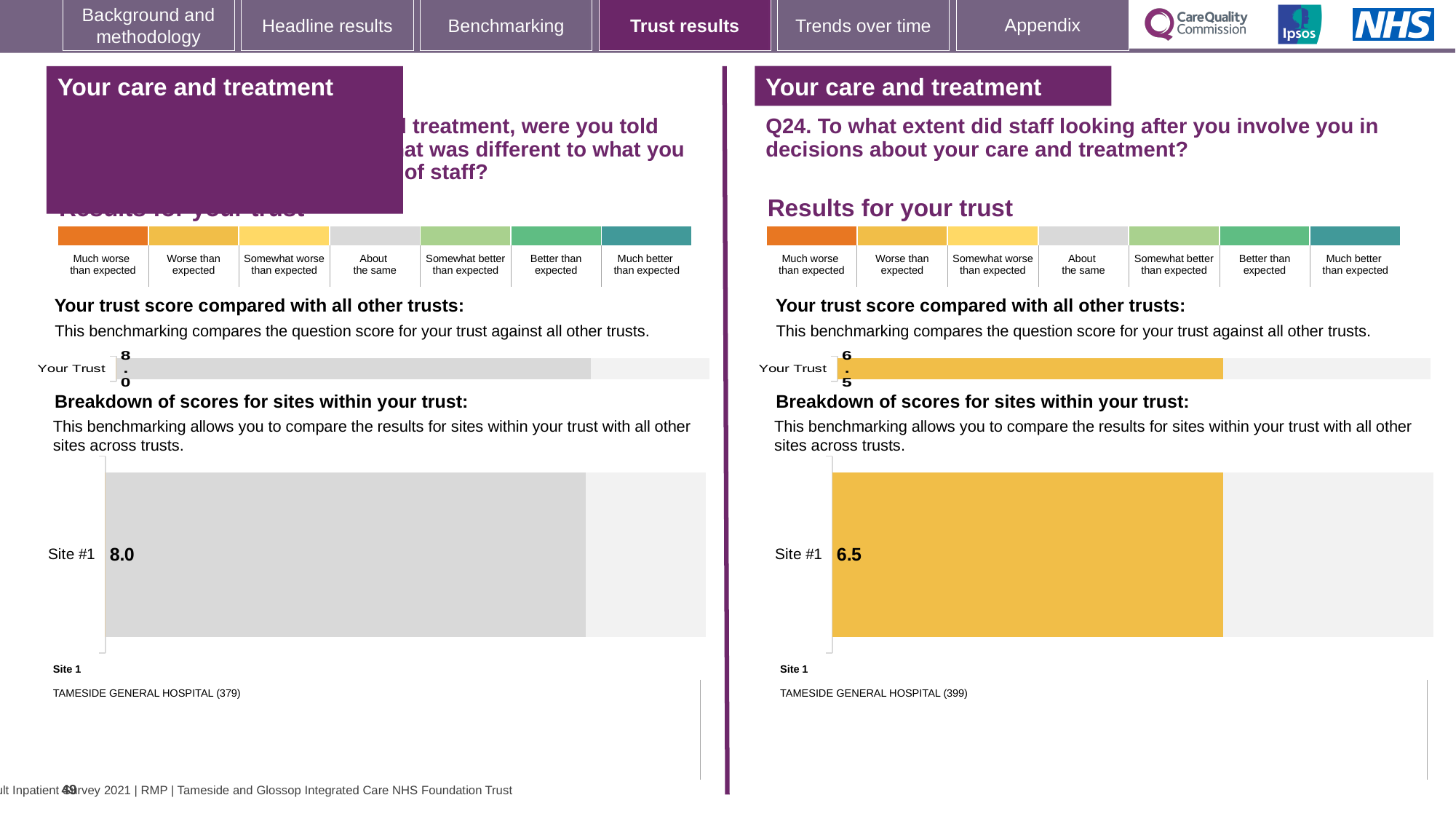
Which is larger: the Site #1 score on the left panel or the Site #1 score on the right panel (Q24)? Left panel (8.0) On the left panel, what is the score shown for Your Trust in the trust benchmarking bar? 8.0 How many sites are shown in the site breakdown chart on the right panel (Q24)? 1 On the right panel (Q24), what is the score shown for Site #1? 6.5 What is the difference between the Site #1 score on the left panel and the Site #1 score on the right panel (Q24)? 1.5 On the right panel (Q24), what is the score shown for Your Trust in the trust benchmarking bar? 6.5 On the left panel, what is the score shown for Site #1? 8.0 Which hospital is listed as Site 1 on the right panel (Q24)? TAMESIDE GENERAL HOSPITAL (399) How many sites are shown in the site breakdown chart on the left panel? 1 What kind of chart is used to show the Site #1 score on the right panel (Q24)? Bar chart On the right panel (Q24), which benchmark category does the yellow colour of the Site #1 bar correspond to in the legend? Worse than expected On the left panel, which benchmark category does the grey colour of the Site #1 bar correspond to in the legend? About the same